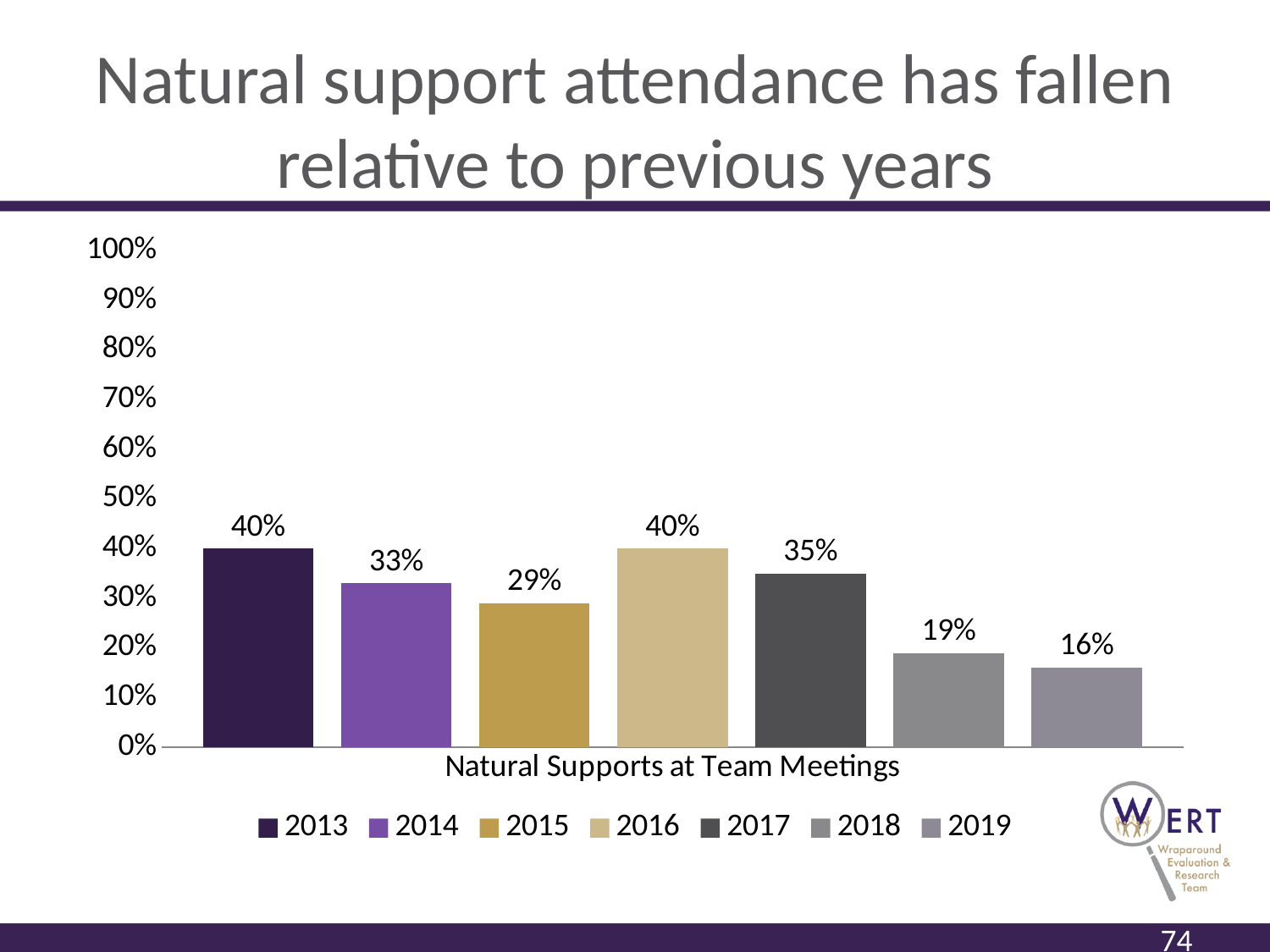
What is the value for 2017? 35% What kind of chart is shown on the slide? Bar chart Which year has the lowest value? 2019 What is the value for 2015? 29% What is the value for 2019 in the Natural Supports at Team Meetings chart? 16% Do the values generally rise or fall from 2016 to 2019? Fall Which is larger, the value for 2014 or the value for 2018? 2014 What is the difference between the values for 2017 and 2018? 16% How many series does the legend list? 7 What is the highest value shown on the y axis? 100% What is the difference between the values for 2013 and 2019? 24% What is the label on the x axis of the chart? Natural Supports at Team Meetings